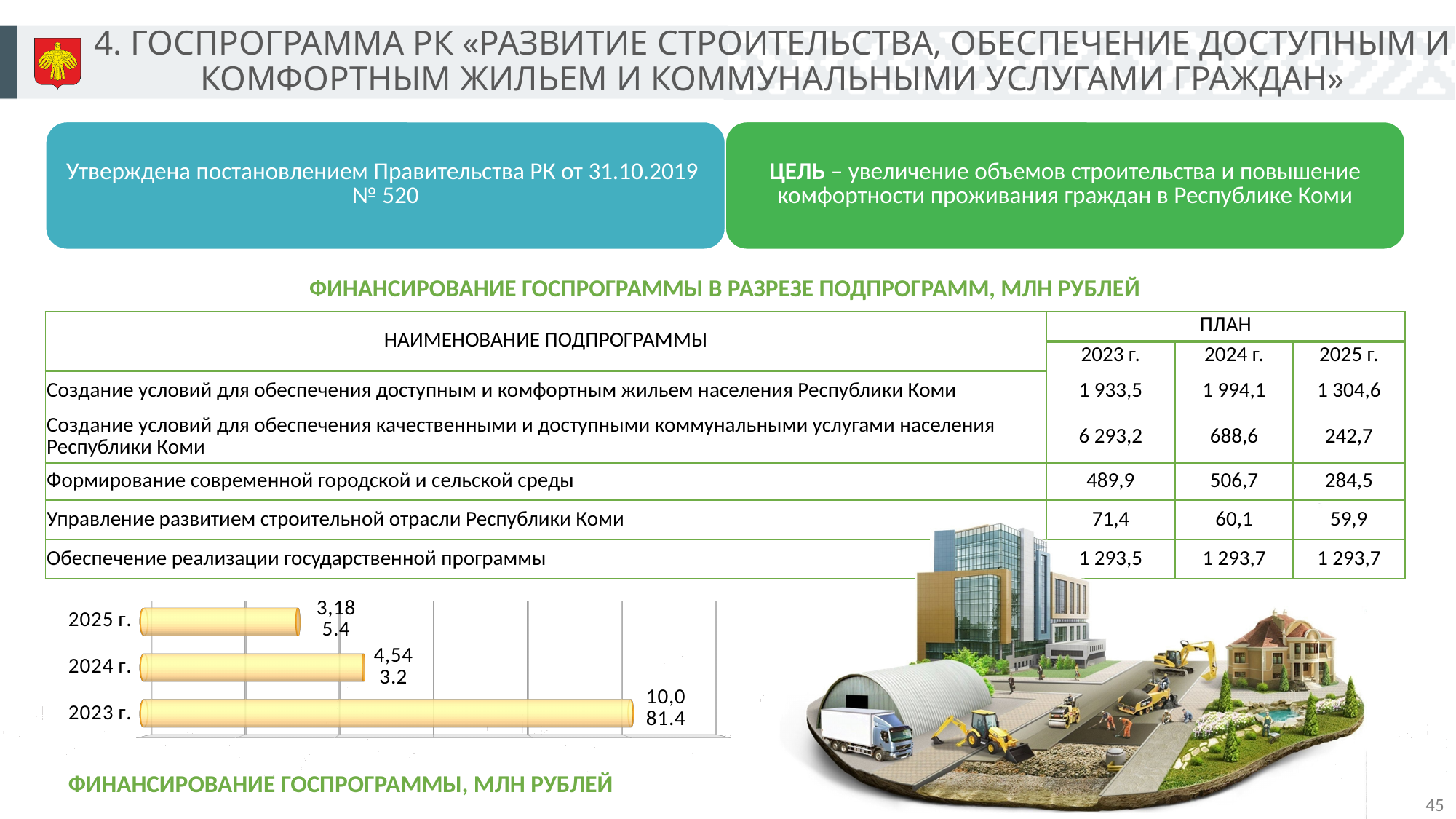
In the bar chart at the bottom left, which year has the longest bar? 2023 г. How many years (categories) are plotted in the bar chart at the bottom left? 3 What colour are the bars in the chart at the bottom left? yellow In the bar chart at the bottom left, which bar is longer: 2024 г. or 2025 г.? 2024 г. What is the title printed under the bar chart at the bottom left? ФИНАНСИРОВАНИЕ ГОСПРОГРАММЫ, МЛН РУБЛЕЙ In the bar chart at the bottom left, which year has the shortest bar? 2025 г. In the bar chart at the bottom left, which bar is longer: 2023 г. or 2024 г.? 2023 г. In the bar chart at the bottom left, do the bar lengths rise or fall as the year goes from 2023 to 2025? fall What kind of chart is shown at the bottom left of the slide? bar chart